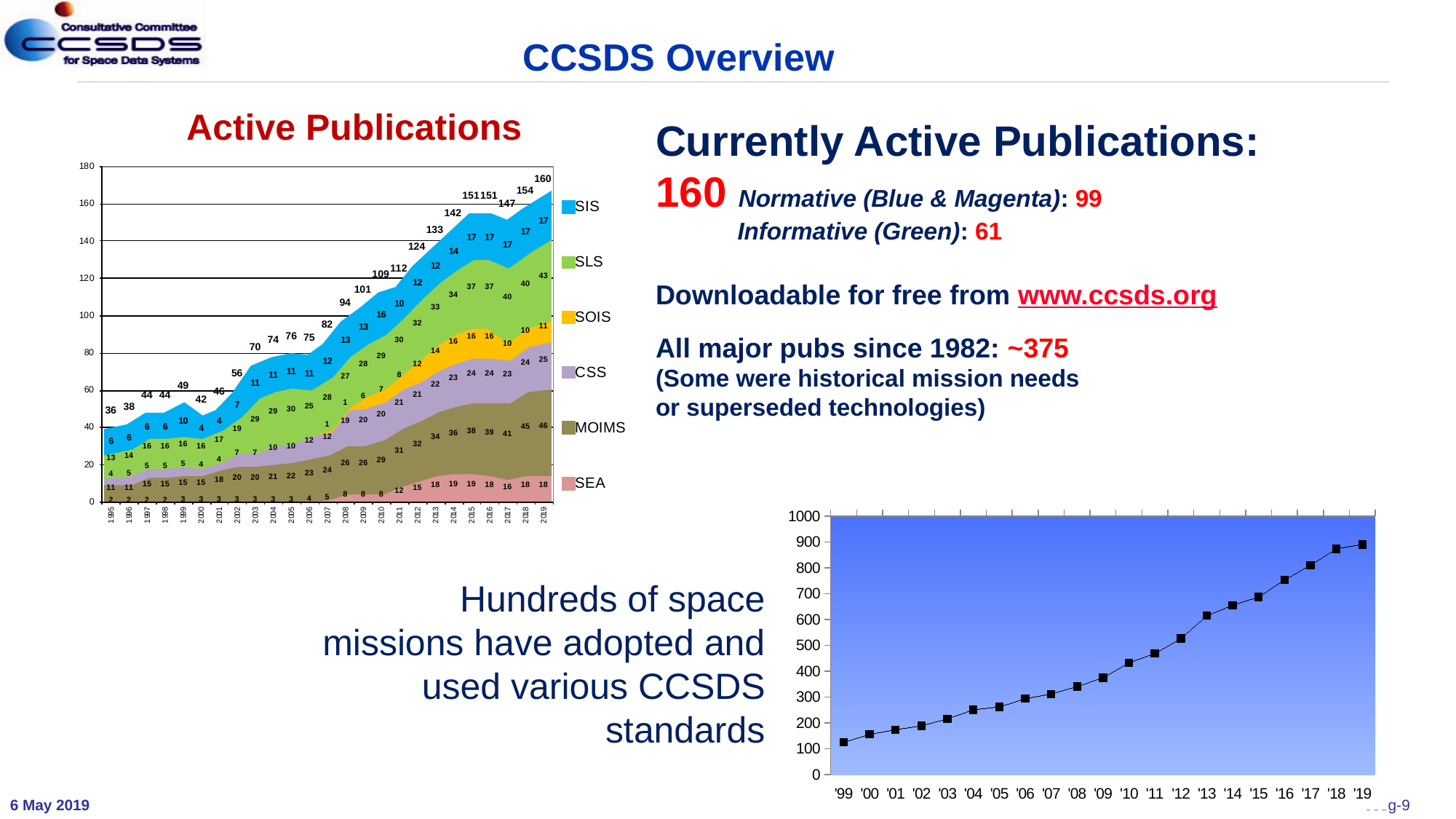
What kind of chart is the Active Publications chart? Stacked area chart In the Active Publications chart, which year has the larger total, 2012 or 2013? 2013 How many series does the legend of the Active Publications chart list? 6 In the Active Publications chart, what is the total number of active publications in 2019? 160 In the Active Publications chart, what is the SLS value for 2019? 43 In the line chart at the bottom right, do the values rise or fall from '99 to '19? rise In the line chart at the bottom right, is the value for '12 greater or less than 600? less In the Active Publications chart, what is the total number of active publications in 2008? 94 In the Active Publications chart, which year has the lowest total of active publications? 1995 In the Active Publications chart, what is the MOIMS value for 2019? 46 In the line chart at the bottom right, is the value for '19 greater or less than 800? greater In the Active Publications chart, what is the difference between the totals for 2019 and 2018? 6